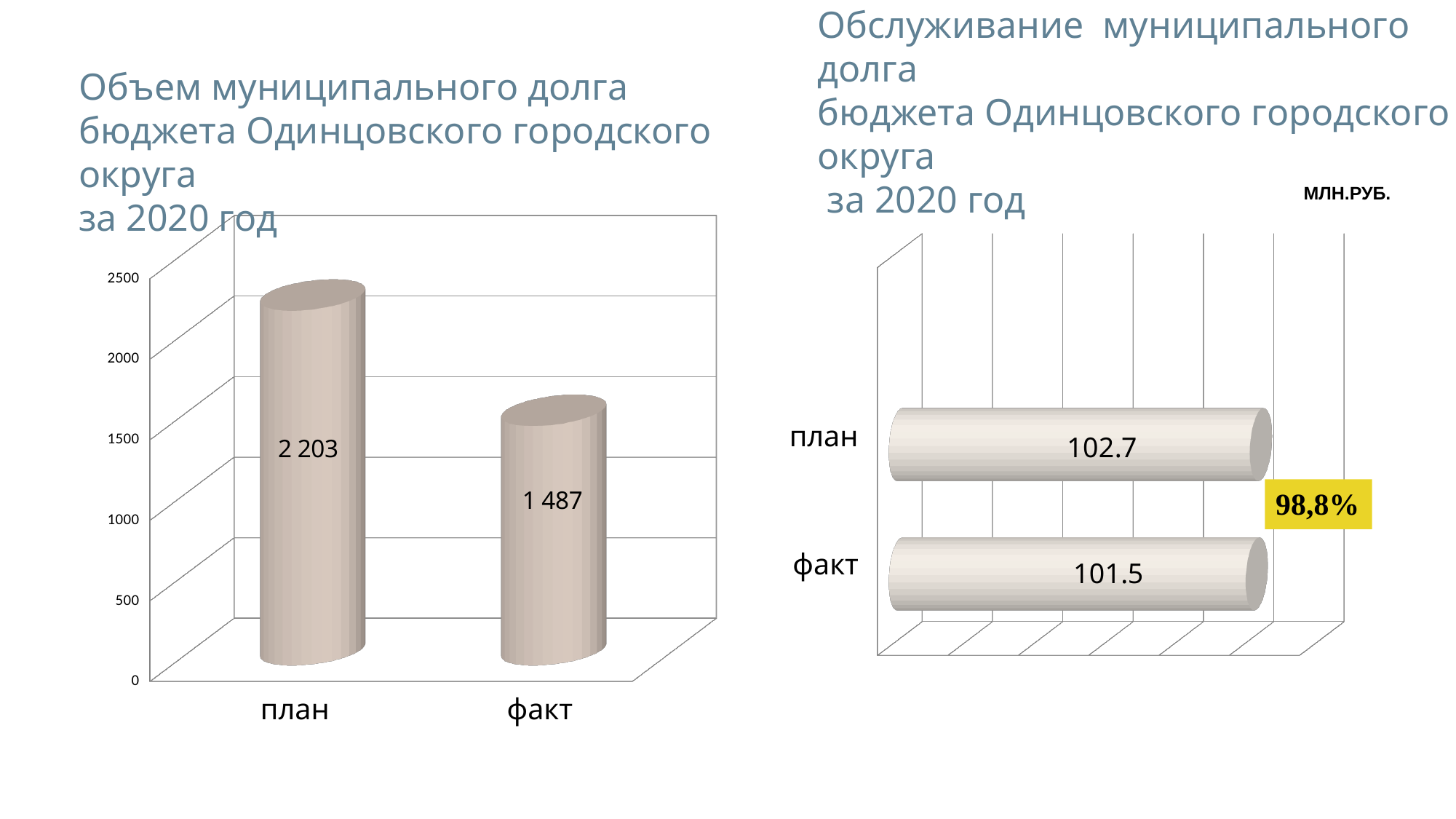
In the left chart (Объем муниципального долга), which category has the higher value? план In the right chart (Обслуживание муниципального долга), which category has the lower value? факт In the right chart (Обслуживание муниципального долга), what is the value for план? 102.7 In the left chart (Объем муниципального долга), what is the difference between план and факт? 716 In the left chart (Объем муниципального долга), is the value for факт greater or less than 1500? less In the left chart (Объем муниципального долга), how many categories are shown? 2 In the right chart (Обслуживание муниципального долга), what is the value for факт? 101.5 In the right chart (Обслуживание муниципального долга), what is the difference between план and факт? 1.2 In the left chart (Объем муниципального долга), what is the value for факт? 1 487 What kind of chart is the left chart (Объем муниципального долга)? bar chart In the left chart (Объем муниципального долга), what is the value for план? 2 203 In the right chart (Обслуживание муниципального долга), what percentage is shown in the yellow box? 98,8%